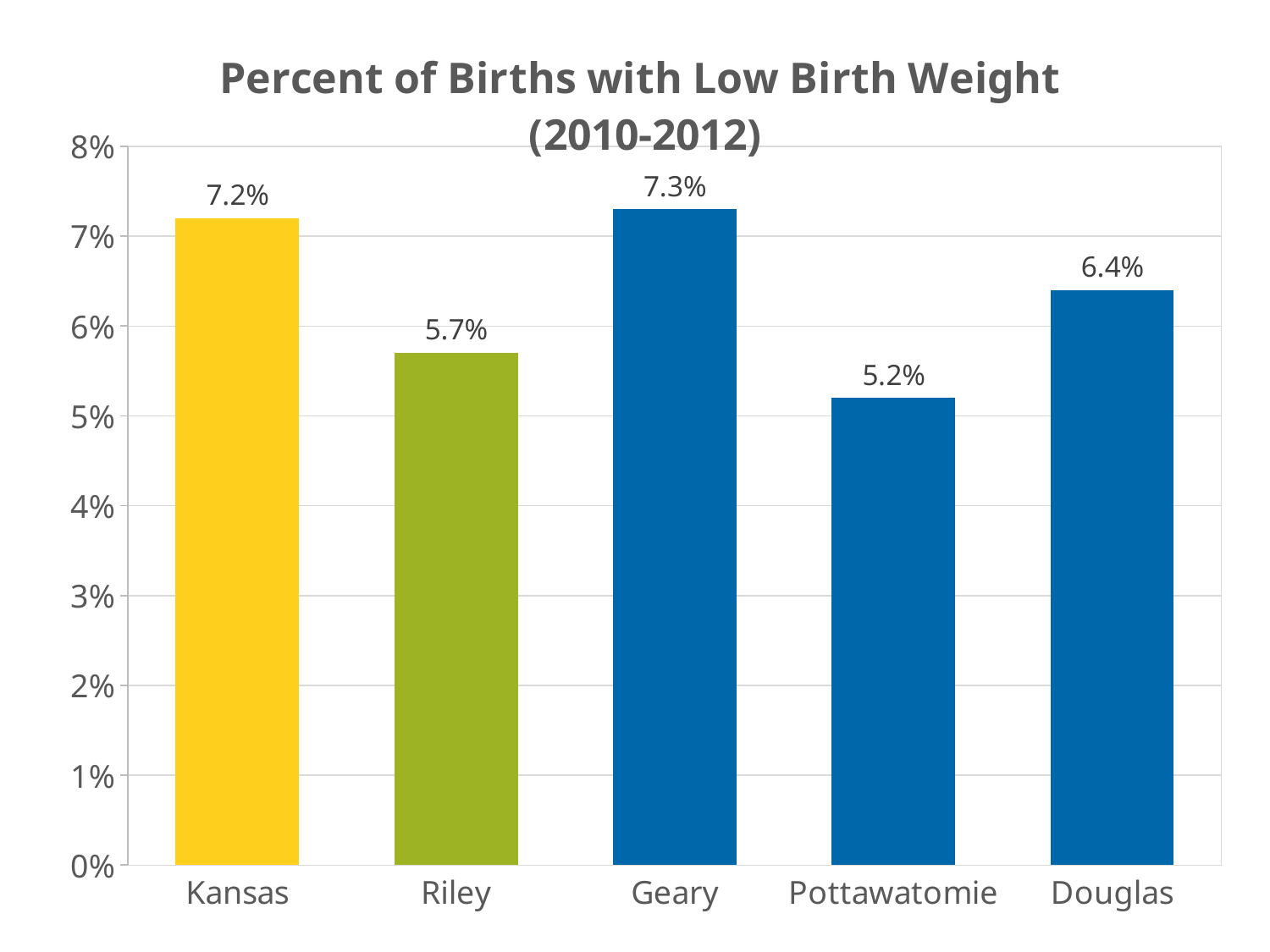
What is the percent of births with low birth weight for Kansas? 7.2% Is the value for Geary greater or less than 7%? greater What is the percent of births with low birth weight for Pottawatomie? 5.2% What is the difference between the values for Douglas and Pottawatomie? 1.2% What is the percent of births with low birth weight for Riley? 5.7% Which category has the lowest percent of births with low birth weight? Pottawatomie Which category has the highest percent of births with low birth weight? Geary What is the percent of births with low birth weight for Douglas? 6.4% What kind of chart is shown on the slide? Bar chart What is the difference between the values for Kansas and Riley? 1.5% How many categories are shown on the chart? 5 Which has a larger value, Riley or Douglas? Douglas